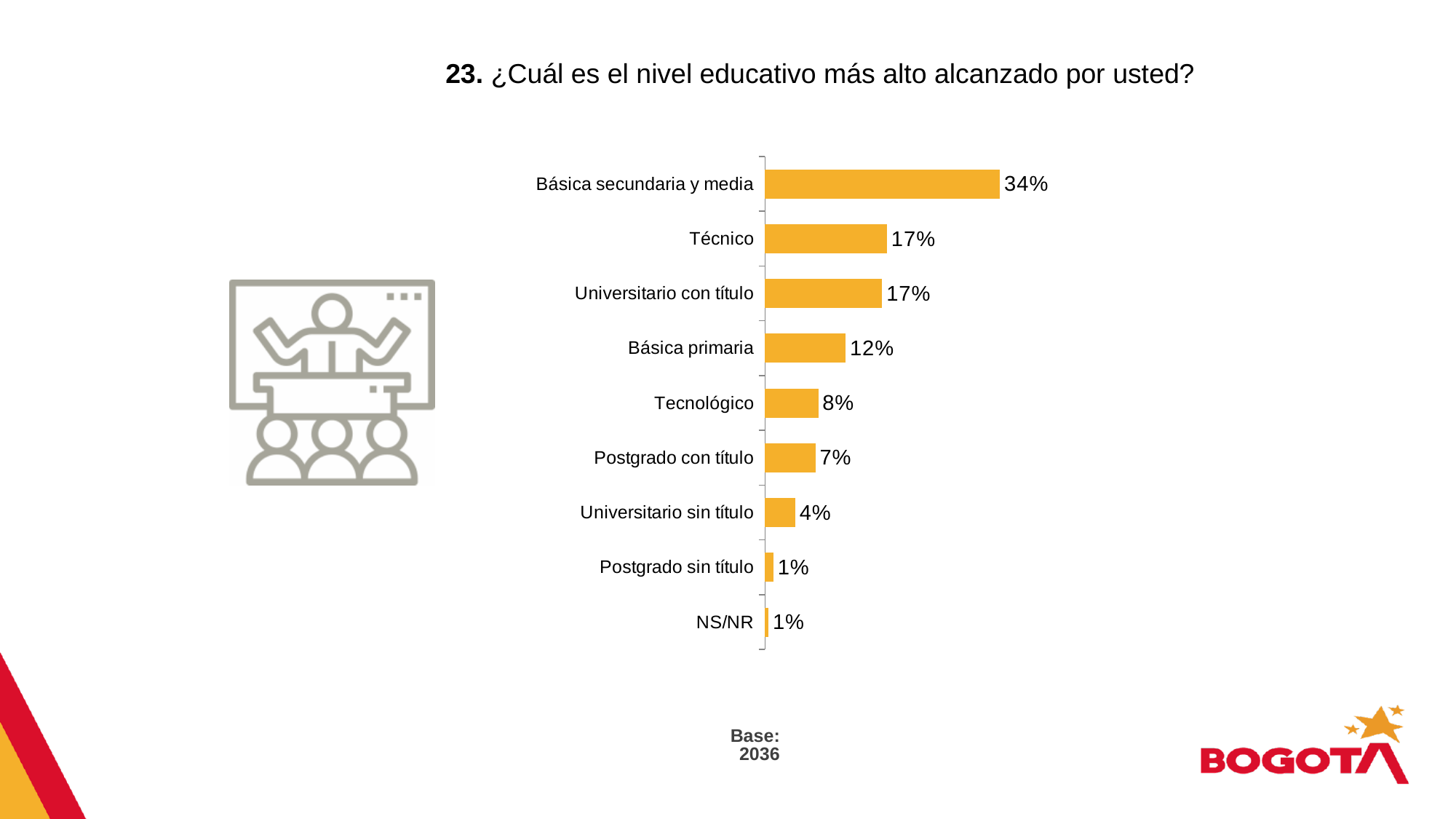
What is the difference between 'Básica primaria' and 'Tecnológico'? 4% What colour are the bars in the chart? Orange What is the base (number of respondents) shown below the chart? 2036 What is the difference between the values for 'Básica secundaria y media' and 'Técnico'? 17% Which education level has the highest percentage? Básica secundaria y media What percentage of respondents reported 'Básica secundaria y media' as their highest education level? 34% Which is larger, the value for 'Tecnológico' or the value for 'Universitario sin título'? Tecnológico How many education-level categories are shown in the chart? 9 What percentage is shown for 'Postgrado con título'? 7% What is the value shown for 'Básica primaria'? 12% What type of chart is shown on the slide? Bar chart What is the value for 'Universitario sin título'? 4%